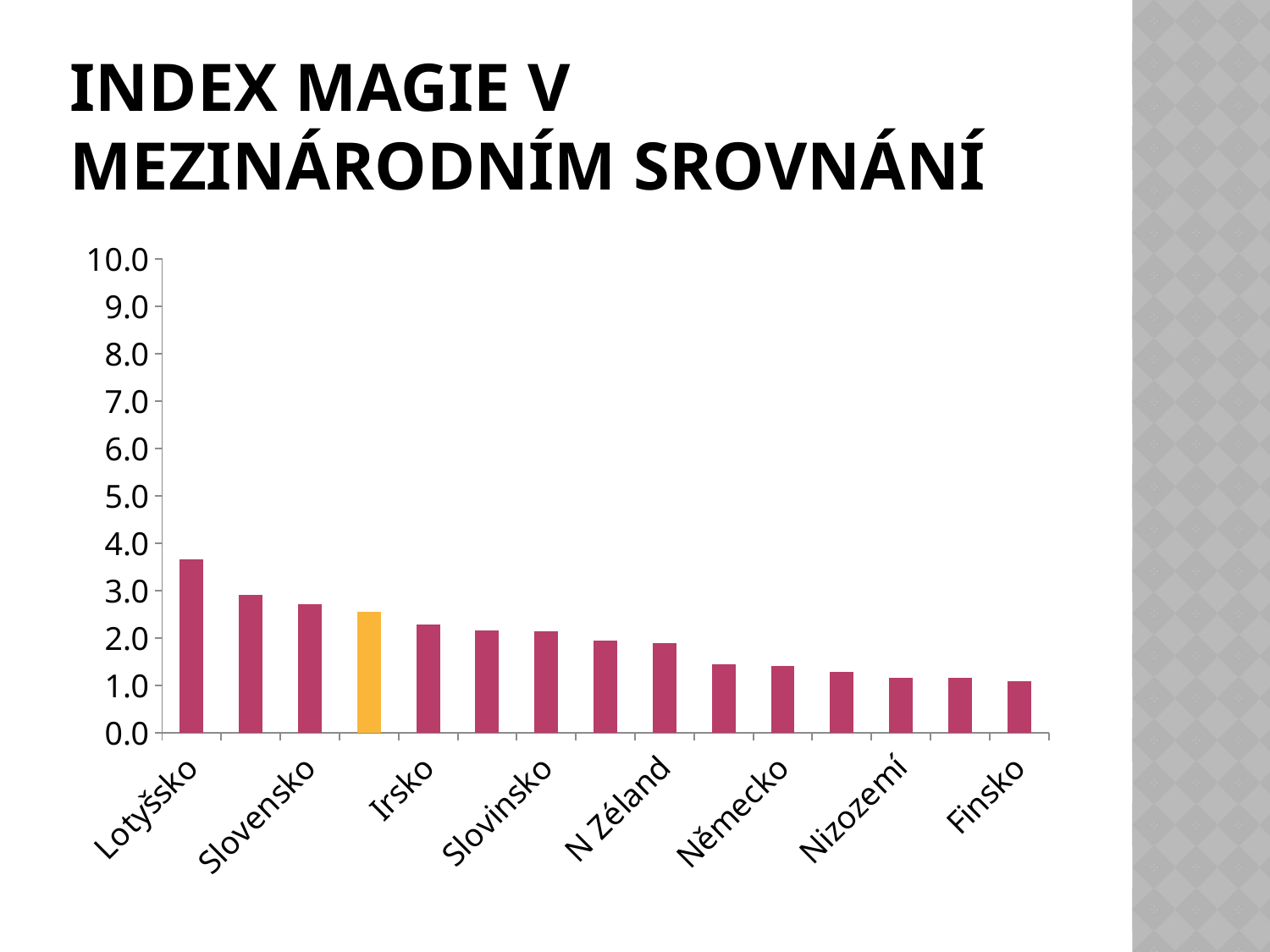
Is the value for Nizozemí greater or less than 2.0? less Is the value for Irsko greater or less than 2.0? greater What is the title of the slide containing the chart? Index magie v mezinárodním srovnání What kind of chart is shown on the slide? bar chart Is the value for Slovensko greater or less than 3.0? less Which is larger, the value for Irsko or the value for Německo? Irsko How many bars are plotted in the chart? 15 Which is larger, the value for Lotyšsko or the value for Slovensko? Lotyšsko Which category has the highest value? Lotyšsko Do the values rise or fall from left to right along the x axis? fall